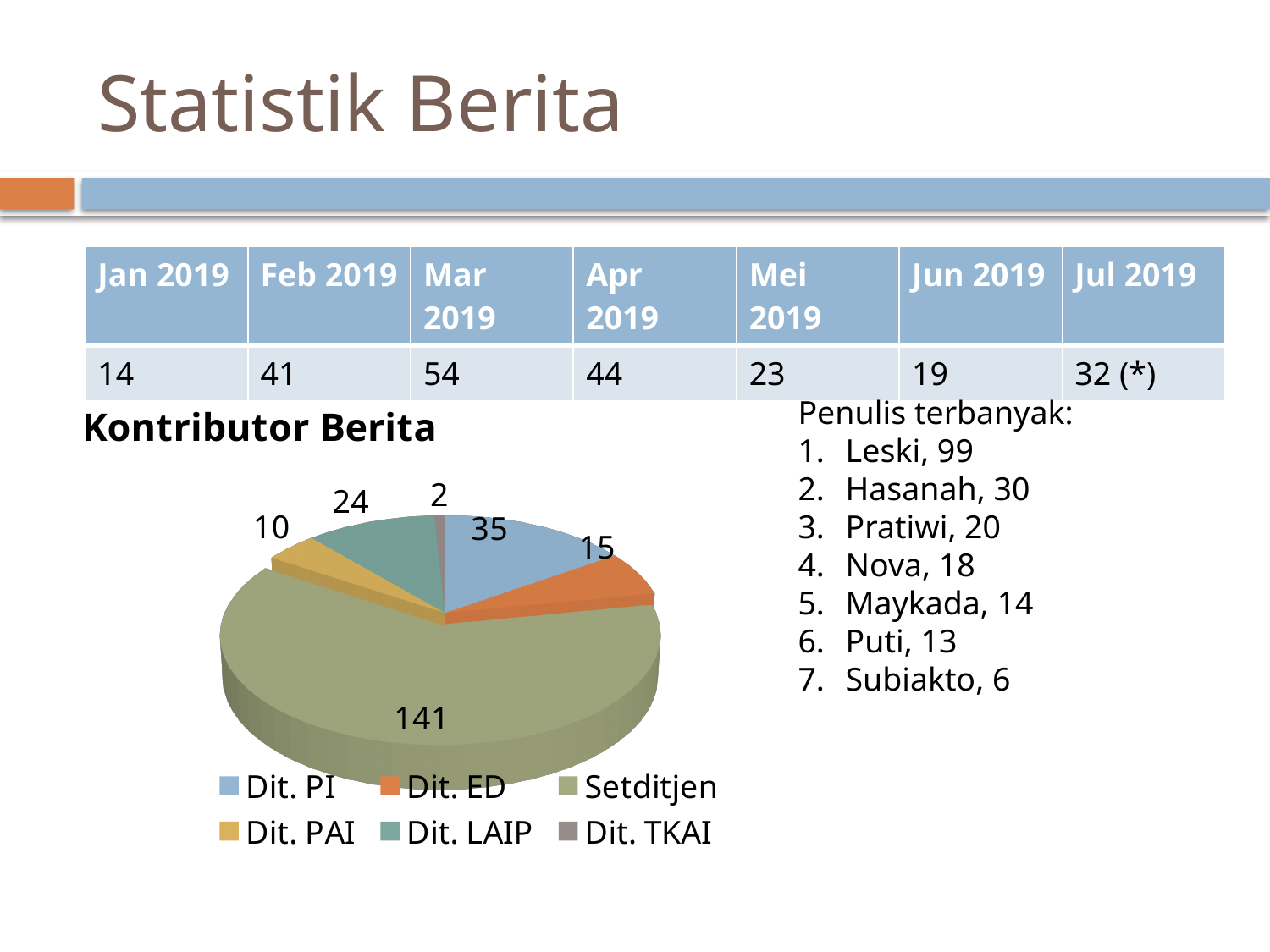
In the Kontributor Berita pie chart, what is the value for Dit. LAIP? 24 How many slices does the Kontributor Berita pie chart have? 6 In the Kontributor Berita pie chart legend, which colour represents Dit. ED? Orange Which contributor has the smallest slice in the Kontributor Berita pie chart? Dit. TKAI In the Kontributor Berita pie chart, what is the value for Dit. TKAI? 2 Which contributor has the largest slice in the Kontributor Berita pie chart? Setditjen What kind of chart is shown under the heading "Kontributor Berita"? Pie chart In the Kontributor Berita pie chart, what is the value for Dit. PI? 35 In the Kontributor Berita pie chart, what is the difference between the values for Dit. PI and Dit. ED? 20 In the Kontributor Berita pie chart, which is larger, Dit. LAIP or Dit. PAI? Dit. LAIP What is the total of all slices in the Kontributor Berita pie chart? 227 In the Kontributor Berita pie chart, what is the value for Setditjen? 141